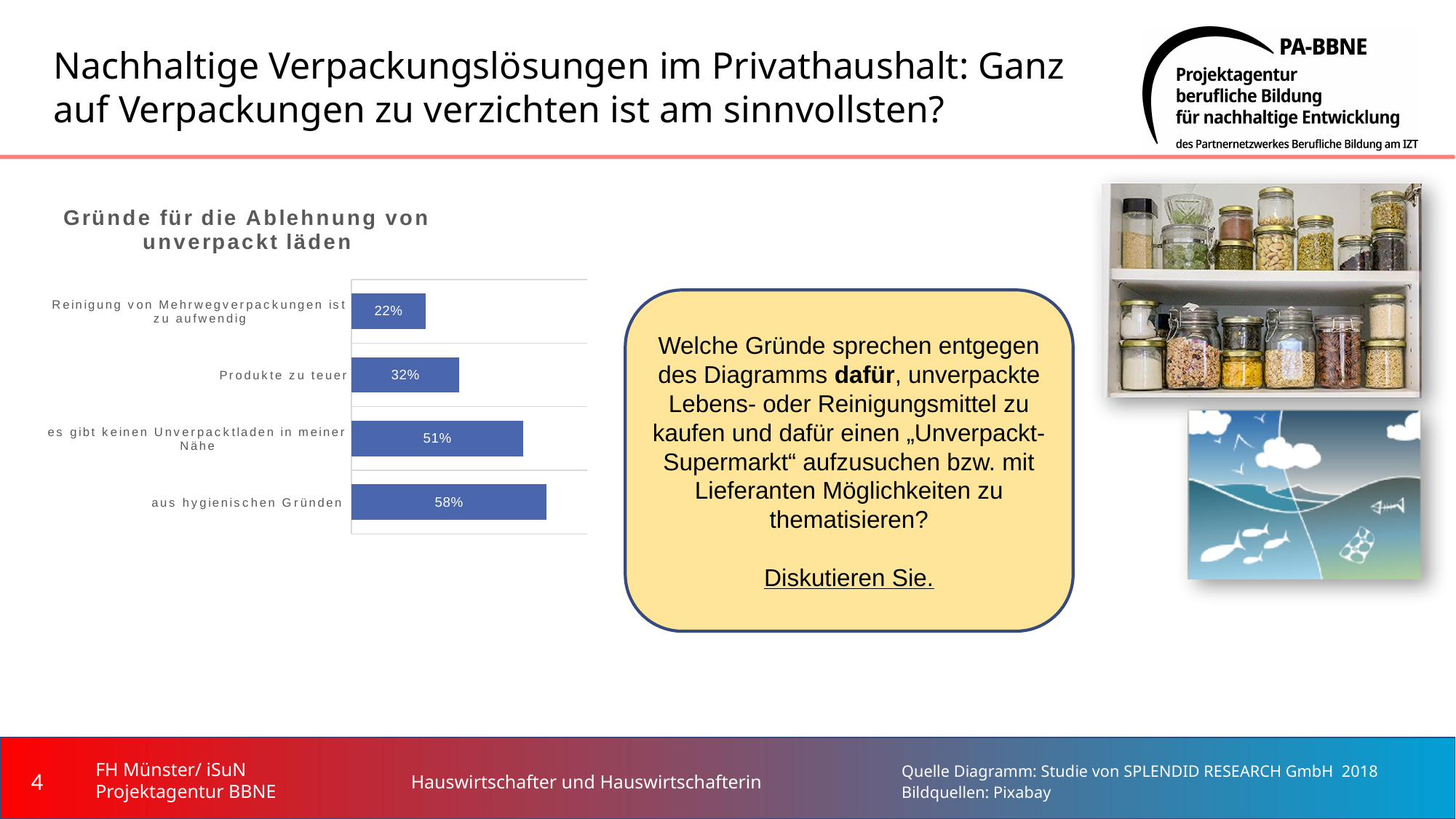
What kind of chart is shown on the slide? Bar chart What is the value for "es gibt keinen Unverpacktladen in meiner Nähe"? 51% What is the difference between "es gibt keinen Unverpacktladen in meiner Nähe" and "Reinigung von Mehrwegverpackungen ist zu aufwendig"? 29% What is the difference between "aus hygienischen Gründen" and "Produkte zu teuer"? 26% How many categories are shown in the chart? 4 Which is larger: "Produkte zu teuer" or "es gibt keinen Unverpacktladen in meiner Nähe"? es gibt keinen Unverpacktladen in meiner Nähe What is the value for "aus hygienischen Gründen"? 58% What is the title of the chart? Gründe für die Ablehnung von unverpackt läden Which category has the highest value? aus hygienischen Gründen What is the value for "Reinigung von Mehrwegverpackungen ist zu aufwendig"? 22% What is the value for "Produkte zu teuer"? 32% Which category has the lowest value? Reinigung von Mehrwegverpackungen ist zu aufwendig